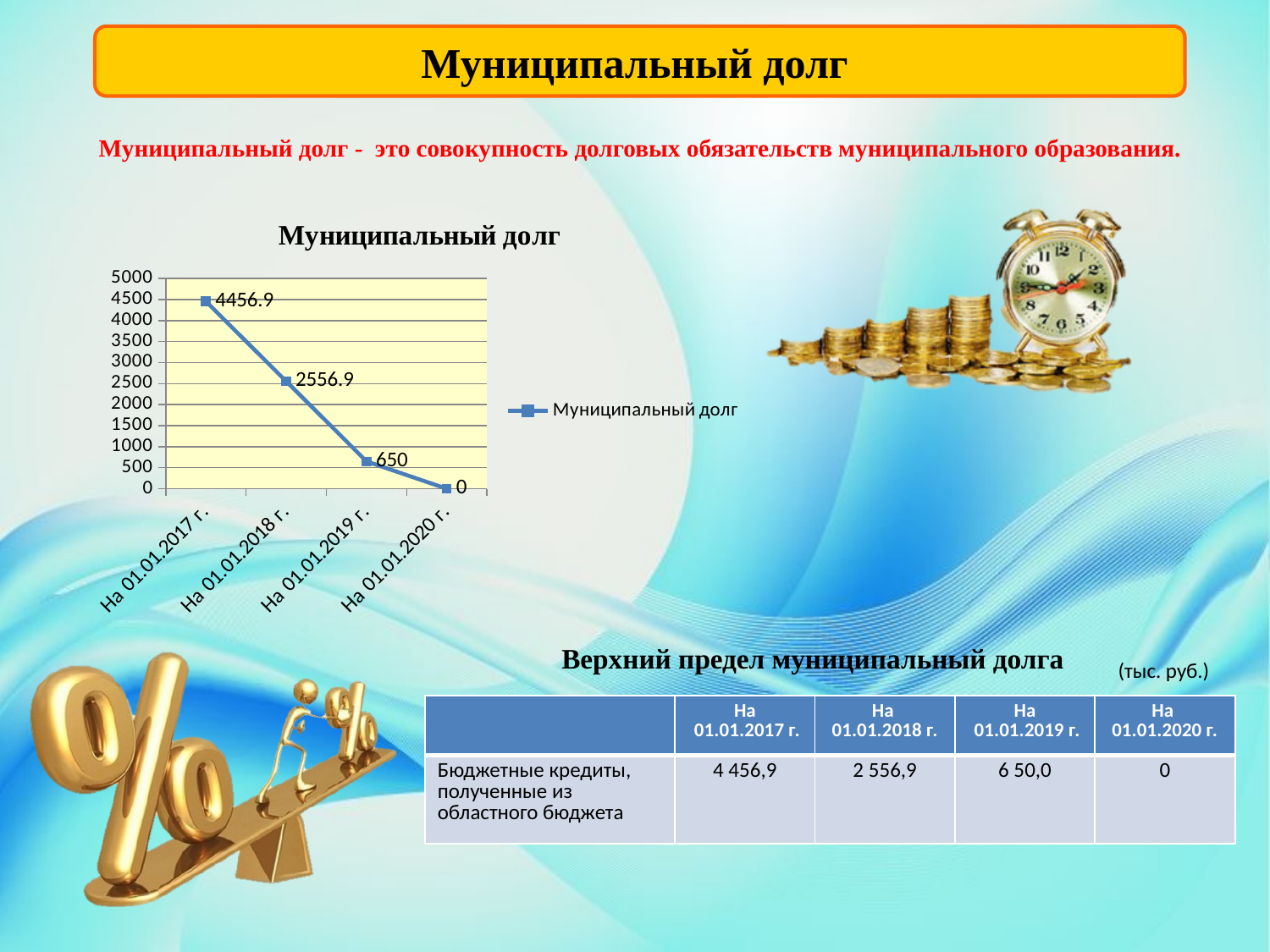
What is the value of Муниципальный долг at На 01.01.2019 г.? 650 Do the values rise or fall from На 01.01.2017 г. to На 01.01.2020 г.? fall What is the difference between the values at На 01.01.2017 г. and На 01.01.2018 г.? 1900 What is the value of Муниципальный долг at На 01.01.2017 г.? 4456.9 What is the value of Муниципальный долг at На 01.01.2018 г.? 2556.9 How many data points are plotted on the chart? 4 What is the value of Муниципальный долг at На 01.01.2020 г.? 0 How many series does the legend list? 1 Which date has the lowest value of Муниципальный долг? На 01.01.2020 г. Which is larger: the value at На 01.01.2018 г. or at На 01.01.2019 г.? На 01.01.2018 г. What kind of chart is shown? line chart Which date has the highest value of Муниципальный долг? На 01.01.2017 г.